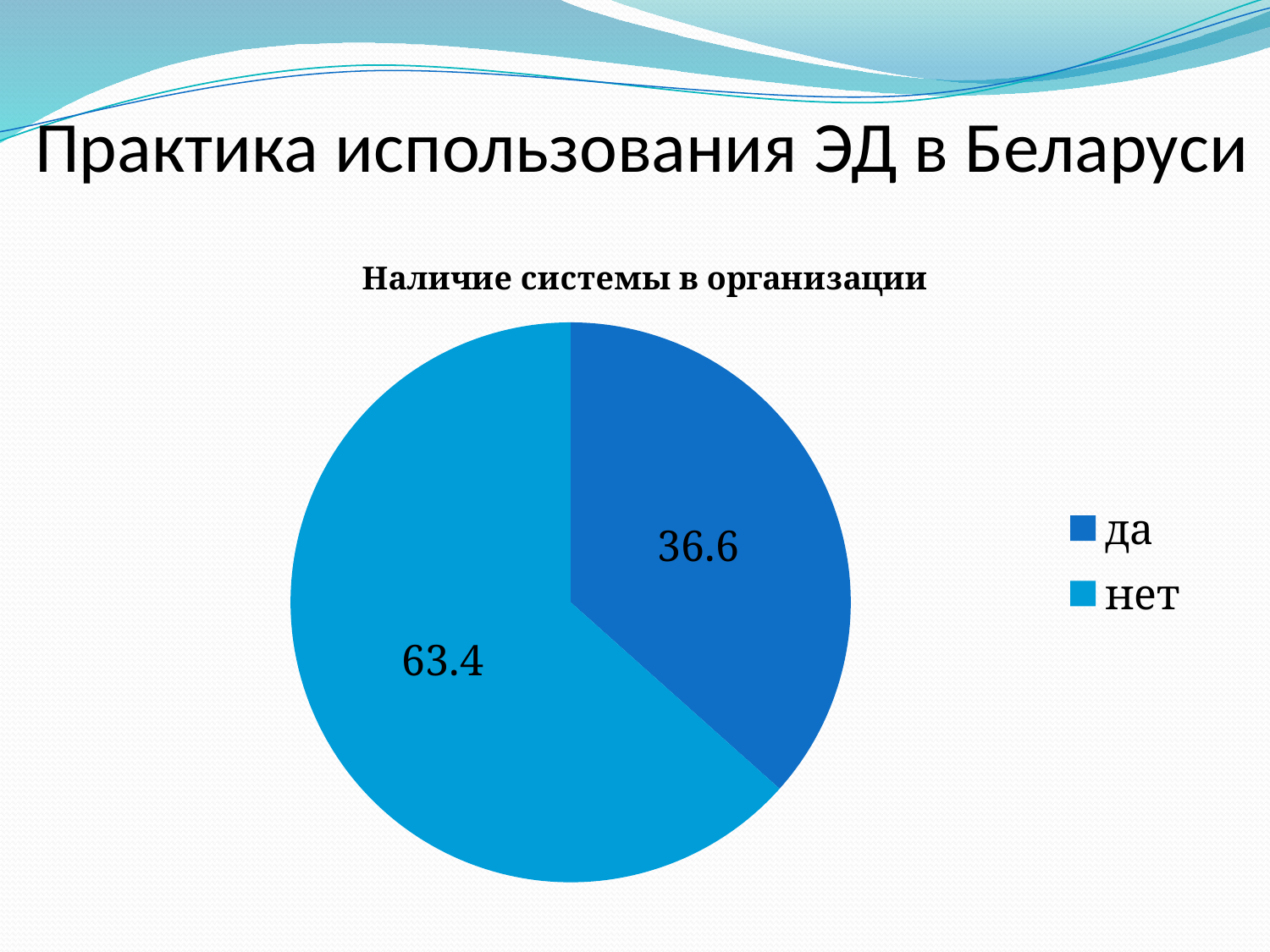
Which slice is the smallest? да Which slice is the largest? нет What is the value for "нет"? 63.4 What kind of chart is shown on the slide? pie chart How many entries does the legend list? 2 What is the value for "да"? 36.6 Which legend entry is shown in the lighter blue colour? нет What is the difference between the values for "нет" and "да"? 26.8 What is the title of the chart? Наличие системы в организации Which is larger, the value for "да" or the value for "нет"? нет How many slices does the pie chart have? 2 What is the total of the two slice values? 100